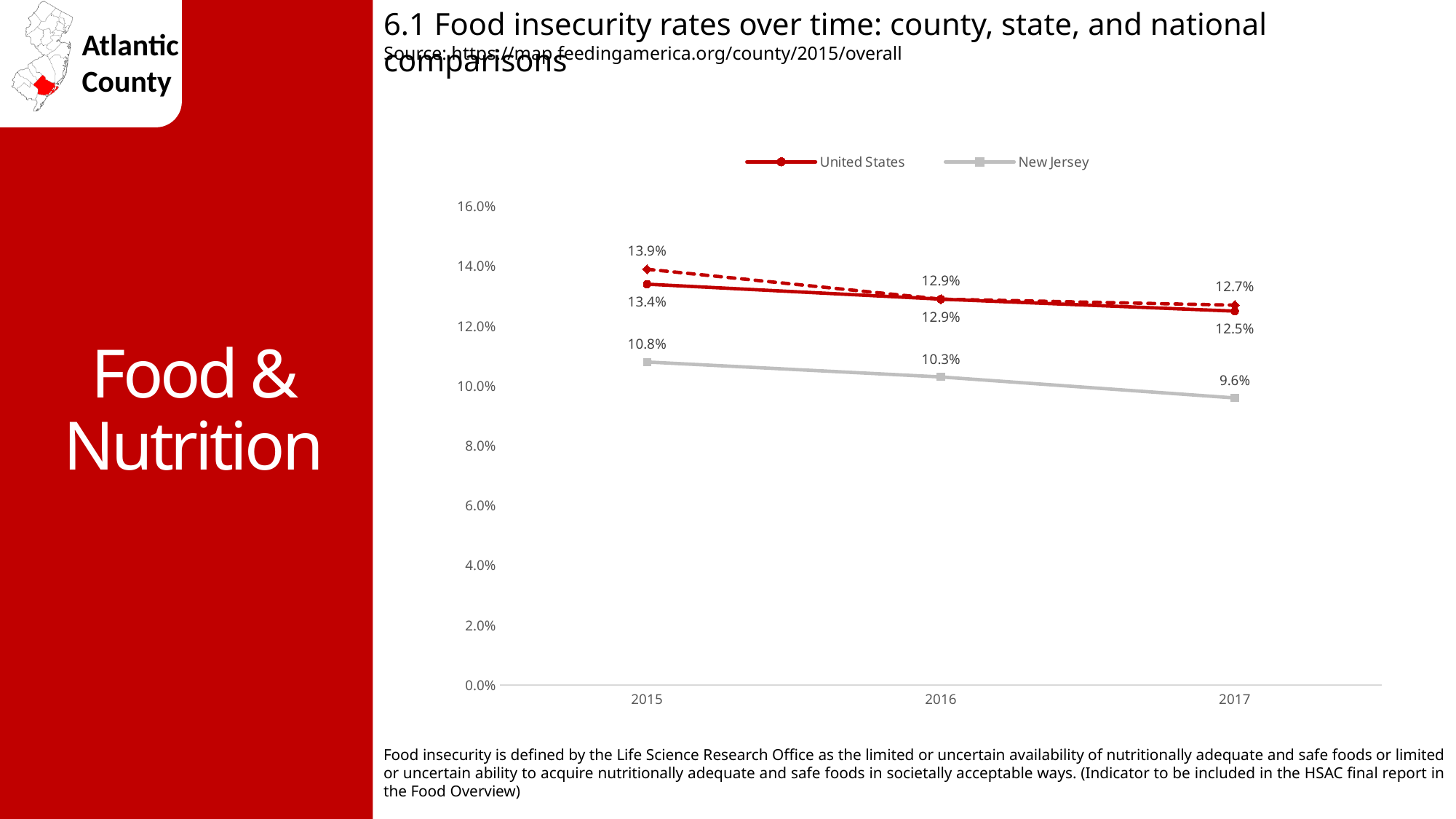
Does the New Jersey food insecurity rate rise or fall from 2015 to 2017? Fall How many series does the chart legend list? 2 In 2016, which had the higher food insecurity rate, the United States or New Jersey? United States By how many percentage points did the New Jersey food insecurity rate fall from 2015 to 2017? 1.2 percentage points What was the food insecurity rate for the United States in 2017? 12.5% What was the food insecurity rate for New Jersey in 2017? 9.6% How many years are shown on the x axis of the chart? 3 In which year was the New Jersey food insecurity rate highest? 2015 What kind of chart is shown on the slide? Line chart What was the food insecurity rate for the United States in 2015? 13.4% What was the food insecurity rate for New Jersey in 2016? 10.3% By how many percentage points did the United States food insecurity rate fall from 2015 to 2017? 0.9 percentage points